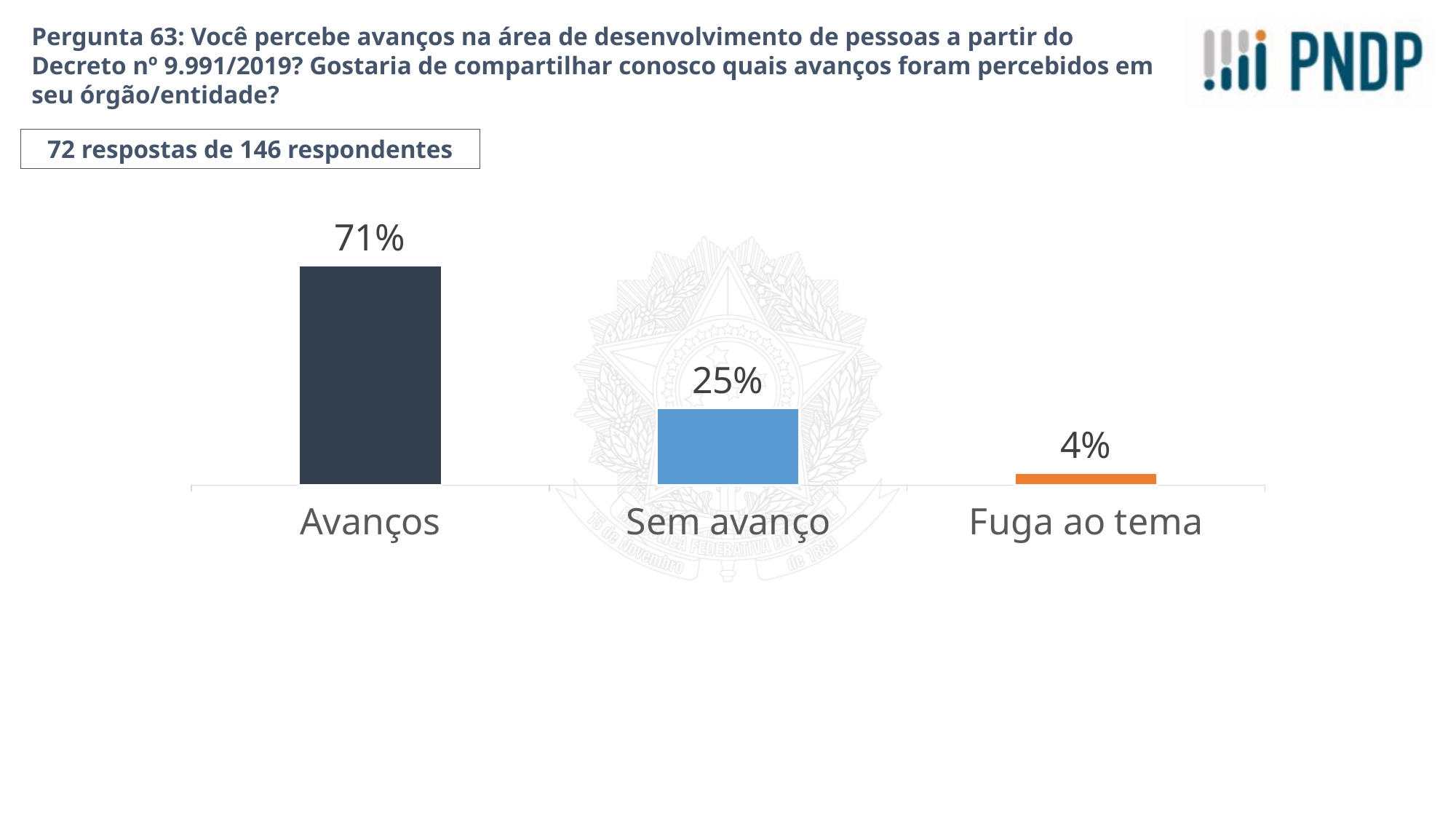
What is the difference between the values for Avanços and Sem avanço? 46% What is the value for Fuga ao tema? 4% Do the values rise or fall from left to right across the categories? Fall What is the value for Sem avanço? 25% What colour is the bar for Fuga ao tema? Orange What kind of chart is shown on the slide? Bar chart How many categories are shown in the chart? 3 What is the value for Avanços? 71% Which category has the highest value? Avanços What is the difference between the values for Sem avanço and Fuga ao tema? 21% Which is larger, the value for Sem avanço or the value for Fuga ao tema? Sem avanço Which category has the lowest value? Fuga ao tema